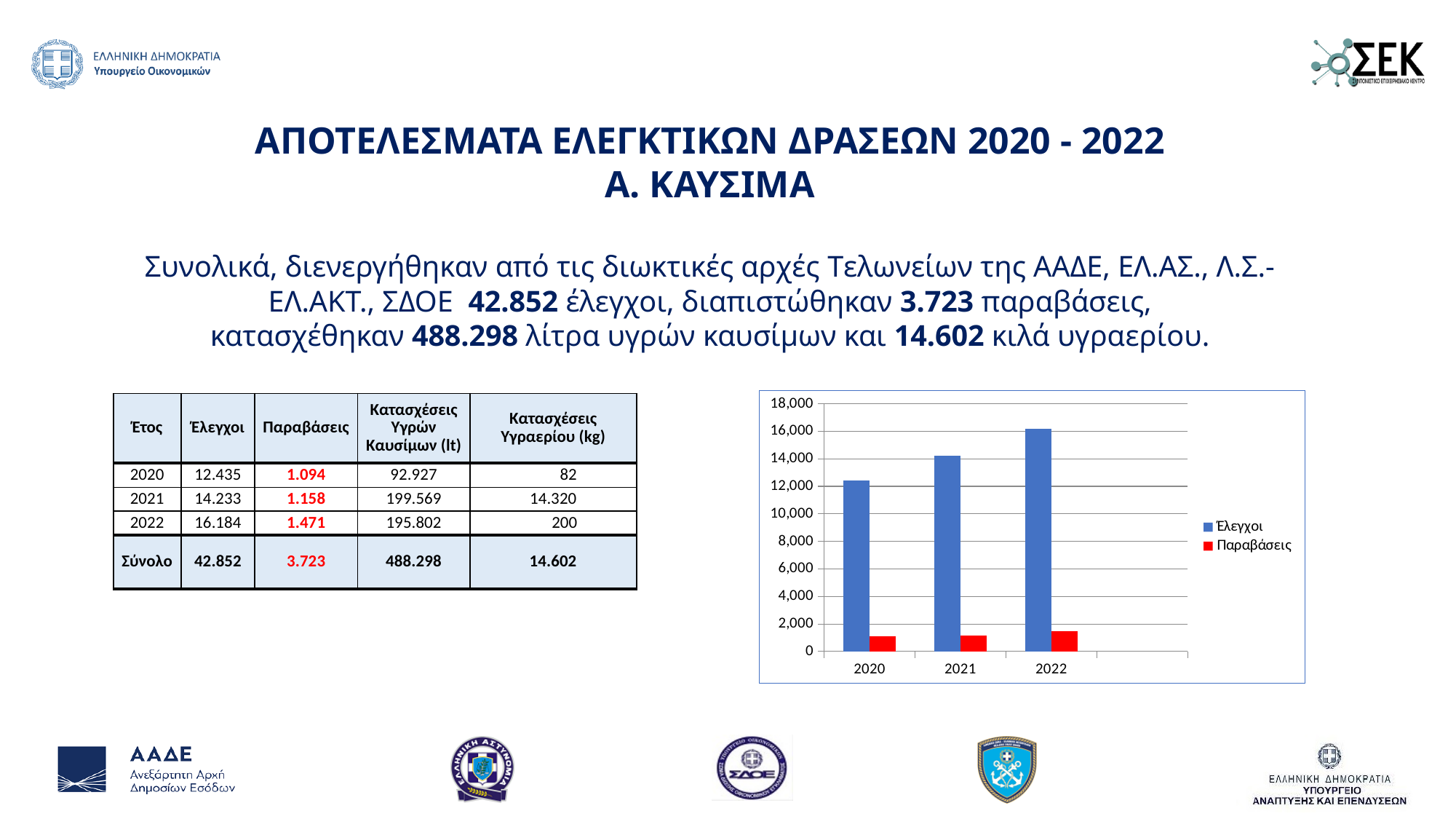
How many years are shown on the x axis of the chart? 3 What colour are the Παραβάσεις bars in the chart? red What kind of chart is shown on the slide? bar chart Which is larger in the chart: Έλεγχοι in 2021 or Έλεγχοι in 2020? Έλεγχοι in 2021 Which year has the lowest value for Έλεγχοι in the chart? 2020 Do the values for Έλεγχοι rise or fall from 2020 to 2022? rise Is the value for Έλεγχοι in 2020 greater or less than 14,000? less How many series does the chart legend list? 2 Is the value for Έλεγχοι in 2022 greater or less than 16,000? greater Which year has the highest value for Έλεγχοι in the chart? 2022 What are the two series named in the chart legend? Έλεγχοι and Παραβάσεις Is the value for Παραβάσεις in 2021 greater or less than 2,000? less